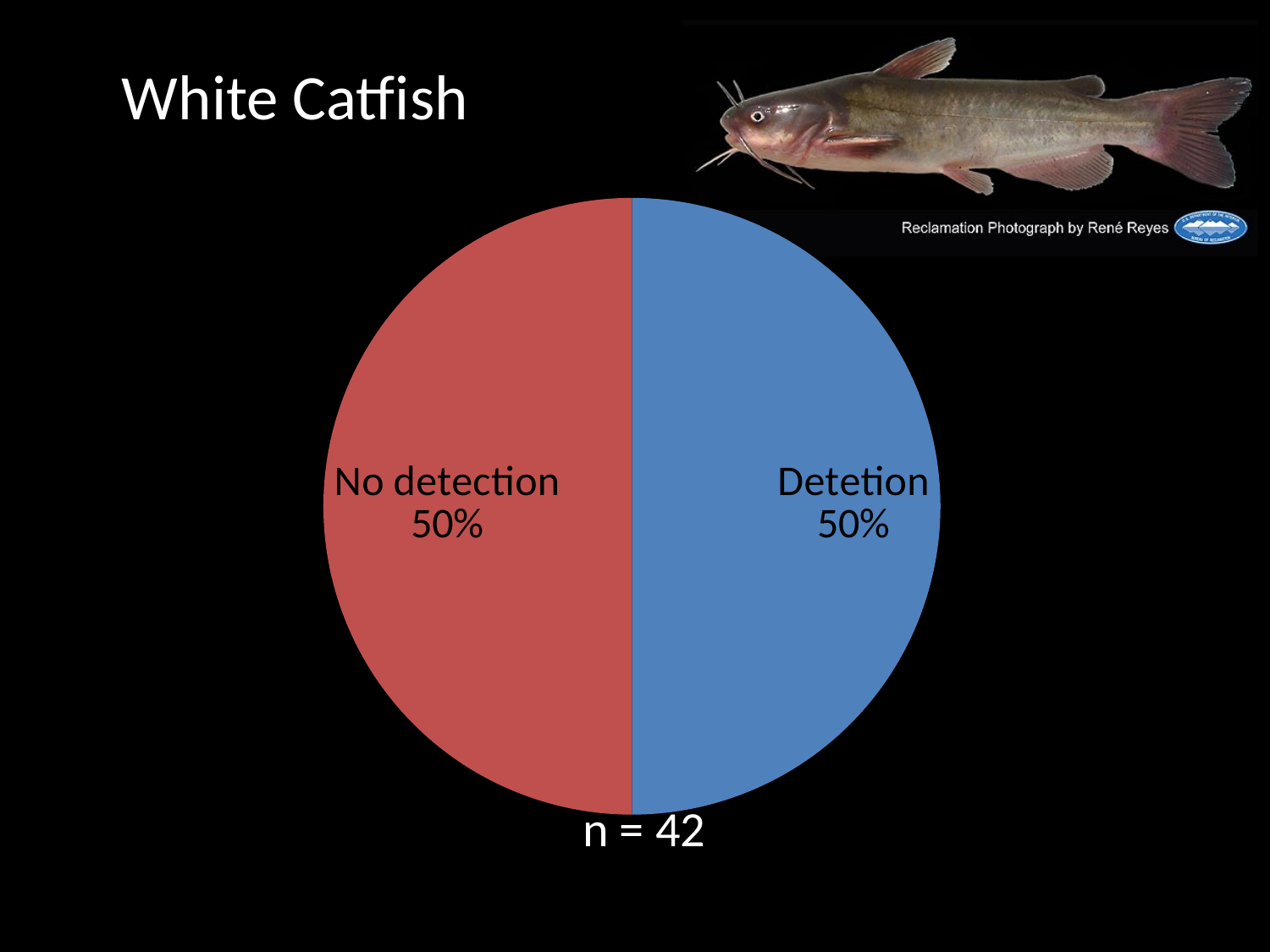
What colour is the "No detection" slice? red Is the share for "Detetion" greater or less than 25%? greater What is the combined share of the "No detection" and "Detetion" slices? 100% What is the title of the slide containing the pie chart? White Catfish What kind of chart is shown on the slide? pie chart What is the difference between the "No detection" share and the "Detetion" share? 0% What share of the pie does the "No detection" slice represent? 50% What is the sample size (n) shown below the pie chart? n = 42 What share of the pie does the "Detetion" slice represent? 50% What colour is the "Detetion" slice? blue How many slices does the pie chart have? 2